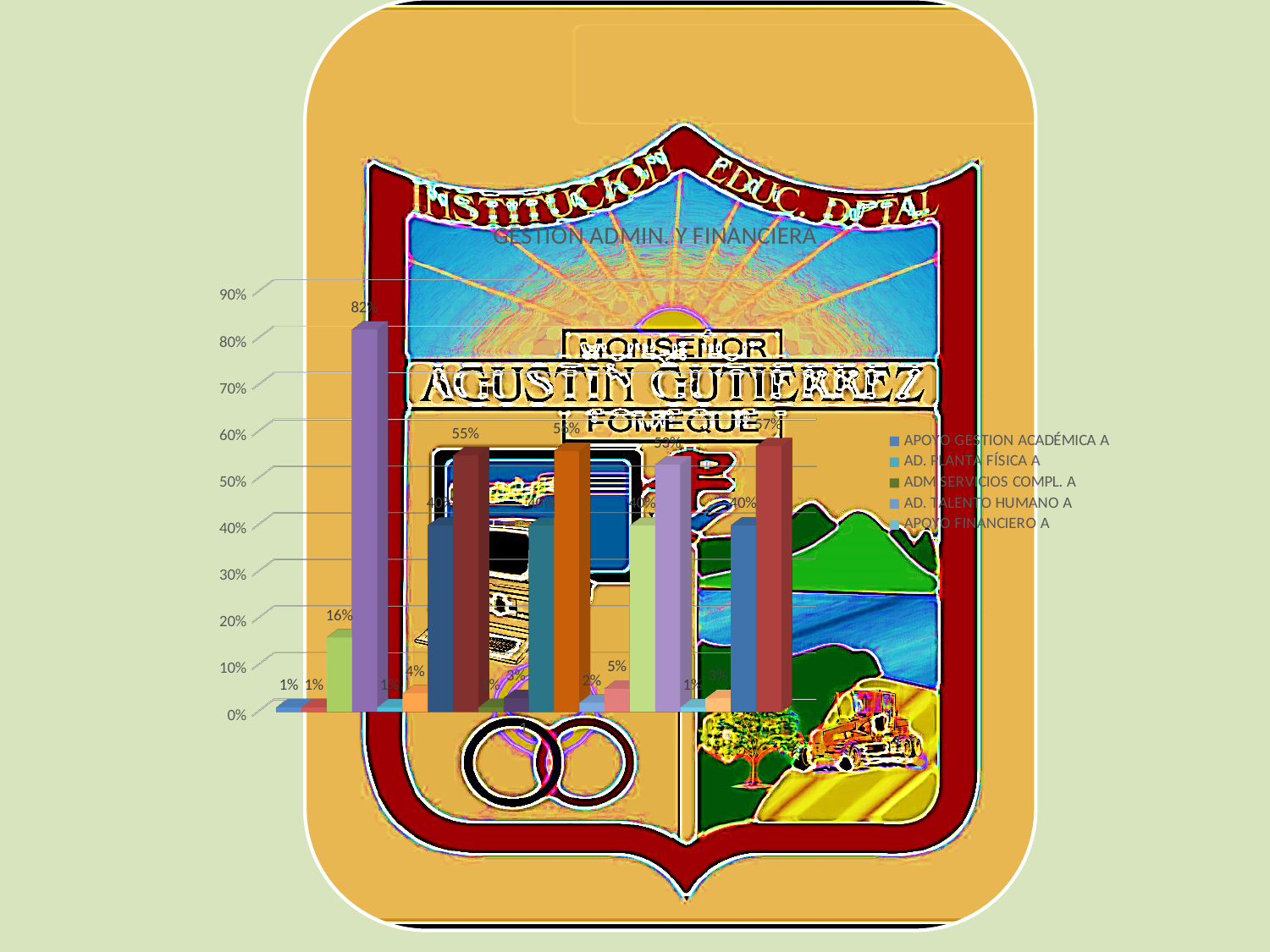
What is the smallest data label value shown on any bar in the chart? 1% What kind of chart is shown on the slide? bar chart What is the value shown on the tallest bar in the chart? 82% What is the title of the chart? GESTION ADMIN. Y FINANCIERA How many series does the chart's legend list? 5 Is the tallest bar in the chart greater or less than 80%? greater What is the first entry listed in the chart's legend? APOYO GESTION ACADÉMICA A Which is larger: the bar labelled 16% or the bar labelled 40%? 40% What is the highest tick value shown on the vertical axis? 90% What is the difference between the tallest bar (82%) and the bar labelled 57%? 25%